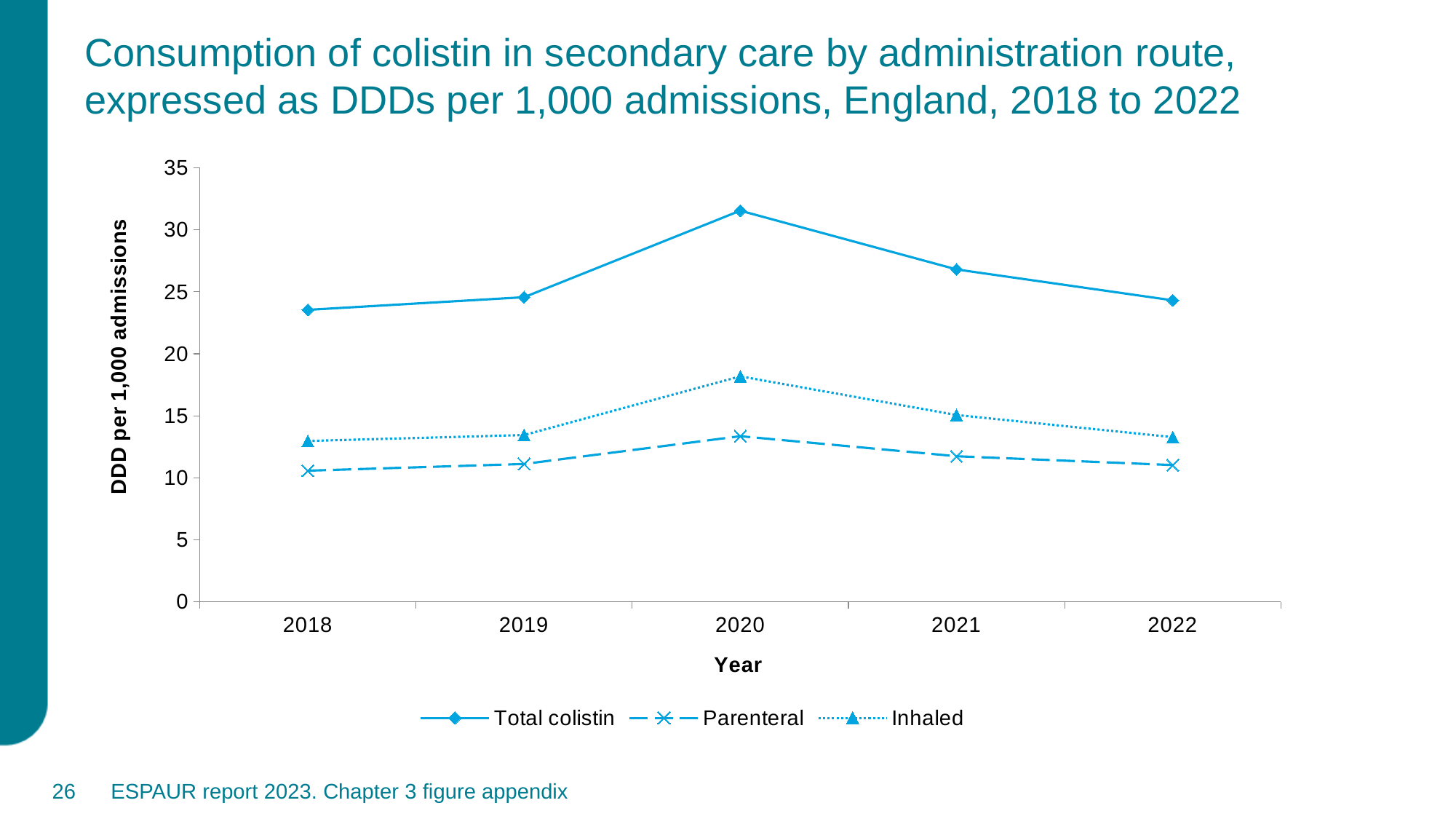
How many series does the legend list? 3 In 2021, which is larger: Inhaled or Parenteral colistin consumption? Inhaled Is the value for Inhaled colistin in 2020 greater or less than 15? greater Does Total colistin consumption rise or fall from 2020 to 2022? Fall In which year is Parenteral colistin consumption lowest? 2018 What is the title of the y axis? DDD per 1,000 admissions In which year is Total colistin consumption highest? 2020 How many years are plotted along the x axis? 5 What type of chart is shown on the slide? Line chart In which year is Inhaled colistin consumption highest? 2020 Is the value for Total colistin in 2020 greater or less than 30? greater Is the value for Parenteral colistin in 2018 greater or less than 15? less